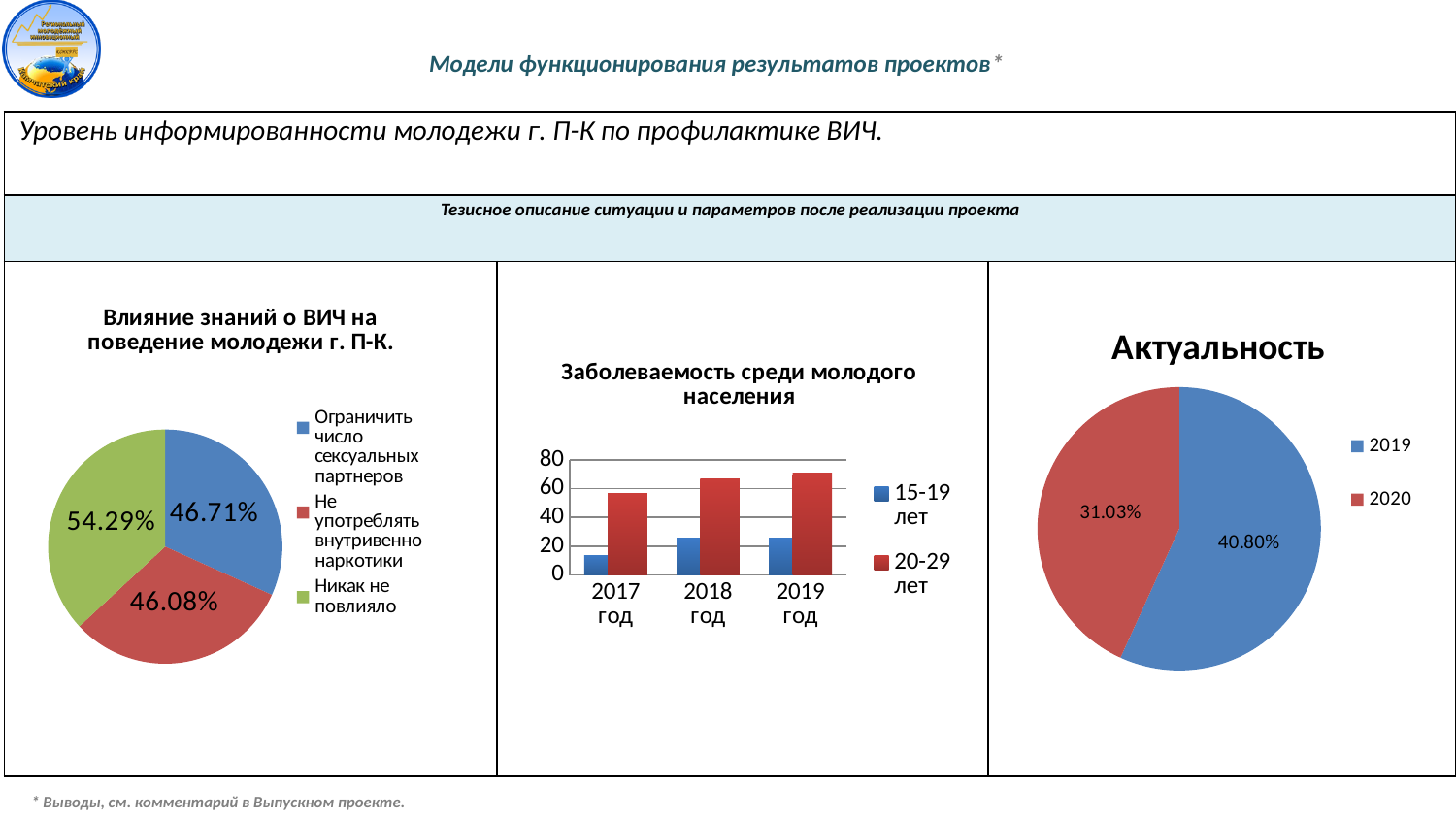
In the chart titled "Влияние знаний о ВИЧ на поведение молодежи г. П-К.", what value is shown for "Ограничить число сексуальных партнеров"? 46.71% What kind of chart is the one titled "Заболеваемость среди молодого населения"? bar chart In the chart titled "Заболеваемость среди молодого населения", is the value for "20-29 лет" in 2019 greater or less than 60? greater In the chart titled "Актуальность", what is the difference between the 2019 and 2020 values? 9.77% In the chart titled "Влияние знаний о ВИЧ на поведение молодежи г. П-К.", which category has the largest value? Никак не повлияло How many year categories are shown on the x axis of the chart titled "Заболеваемость среди молодого населения"? 3 In the chart titled "Актуальность", what value is shown for 2020? 31.03% How many series does the legend of the chart titled "Заболеваемость среди молодого населения" list? 2 In the chart titled "Актуальность", what value is shown for 2019? 40.80% In the chart titled "Влияние знаний о ВИЧ на поведение молодежи г. П-К.", what value is shown for "Не употреблять внутривенно наркотики"? 46.08% In the chart titled "Влияние знаний о ВИЧ на поведение молодежи г. П-К.", what value is shown for "Никак не повлияло"? 54.29% In the chart titled "Заболеваемость среди молодого населения", do the values for "20-29 лет" rise or fall from 2017 to 2019? rise